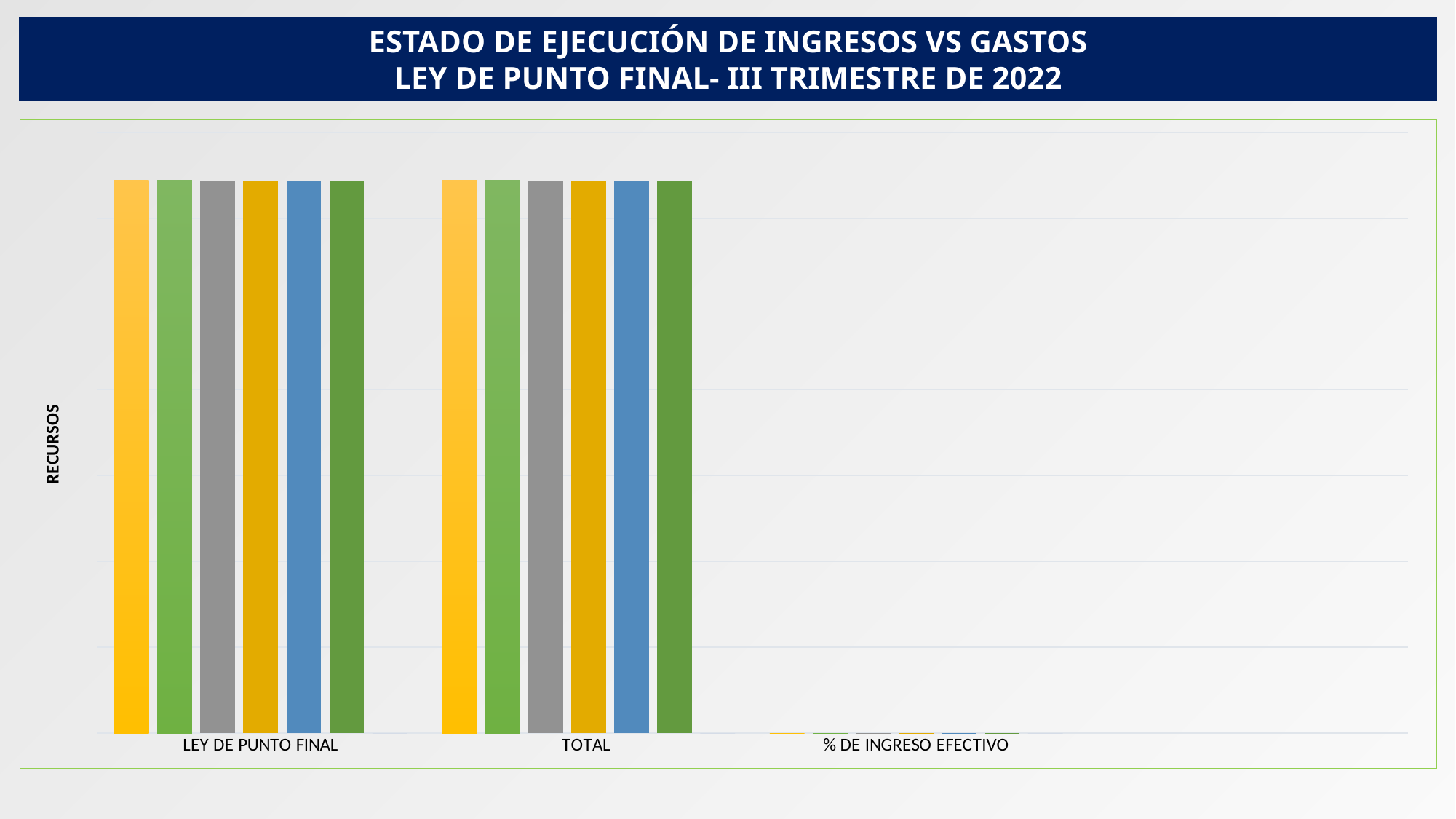
How many categories are shown along the x axis of the chart? 3 Do the bar heights rise or fall from TOTAL to % DE INGRESO EFECTIVO along the x axis? Fall What kind of chart is shown on the slide? Bar chart Which category has the lowest bars in the chart? % DE INGRESO EFECTIVO How many bars are plotted for the category TOTAL? 6 Are the bars for TOTAL taller or shorter than the bars for % DE INGRESO EFECTIVO? Taller Are the bars for LEY DE PUNTO FINAL taller or shorter than the bars for % DE INGRESO EFECTIVO? Taller How many bars are plotted for the category LEY DE PUNTO FINAL? 6 What is the title of the vertical axis of the chart? RECURSOS What are the category labels along the x axis of the chart? LEY DE PUNTO FINAL, TOTAL, % DE INGRESO EFECTIVO